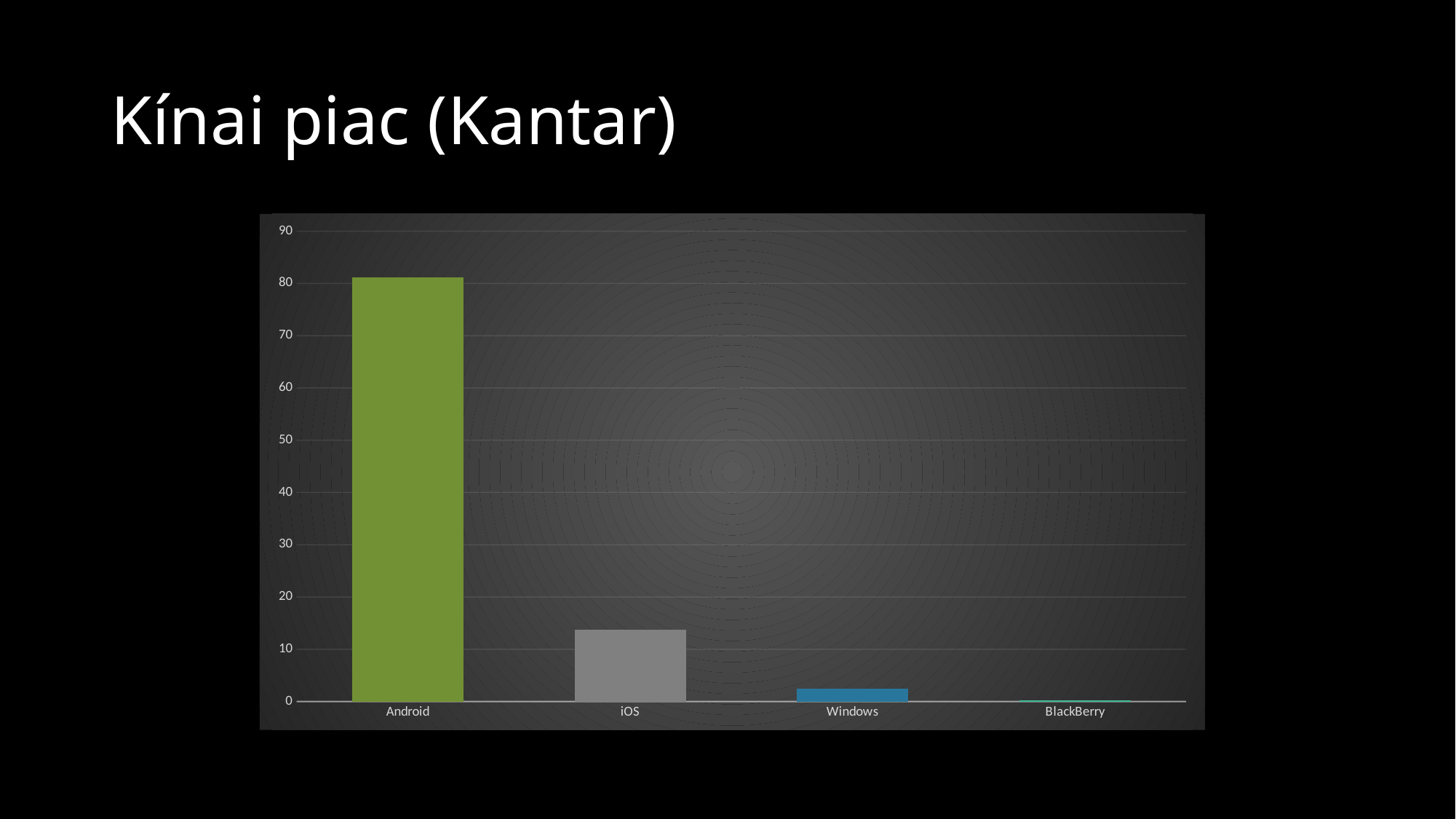
Which category has the lowest value in the chart? BlackBerry What colour is the bar for Android? green What is the title of the slide containing the chart? Kínai piac (Kantar) Is the value for Windows greater or less than 10? less What kind of chart is shown on the slide? bar chart Which is larger, the value for Android or the value for iOS? Android Do the values rise or fall moving from Android to BlackBerry along the x axis? fall Which is larger, the value for iOS or the value for Windows? iOS How many categories are shown on the x axis of the chart? 4 Which category has the highest value in the chart? Android Is the value for iOS greater or less than 20? less